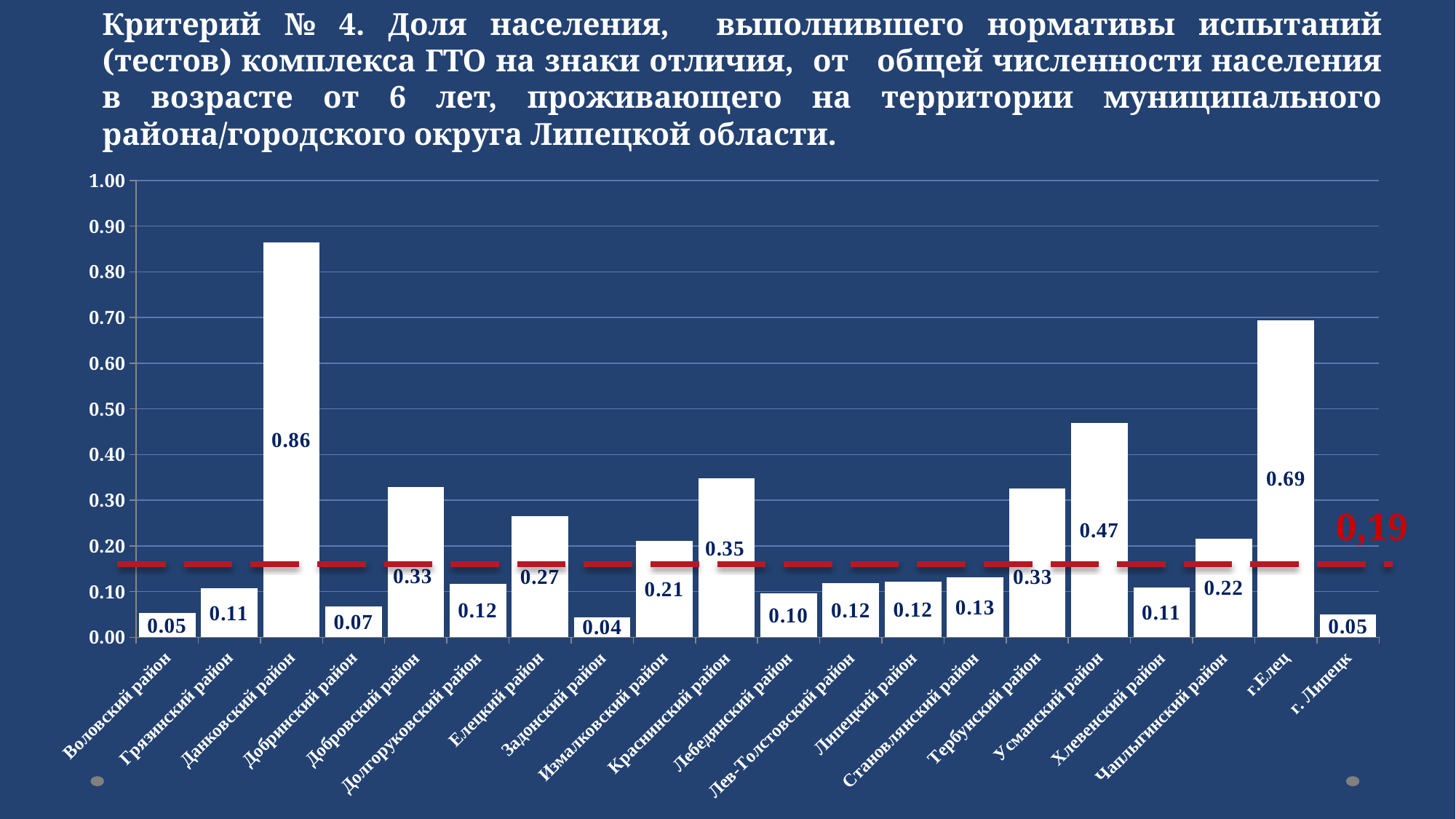
What is the difference between the values for Усманский район and Тербунский район? 0.14 What is the value for Задонский район? 0.04 Which category has the highest value? Данковский район What is the value for Усманский район? 0.47 What is the value for г.Елец? 0.69 Which category has the lowest value? Задонский район What kind of chart is shown on the slide? Bar chart What is the value for Данковский район? 0.86 What is the difference between the values for Данковский район and г.Елец? 0.17 What value is written next to the red dashed horizontal line? 0,19 Which is larger, the value for Краснинский район or the value for Добровский район? Краснинский район How many categories are shown on the x axis? 20